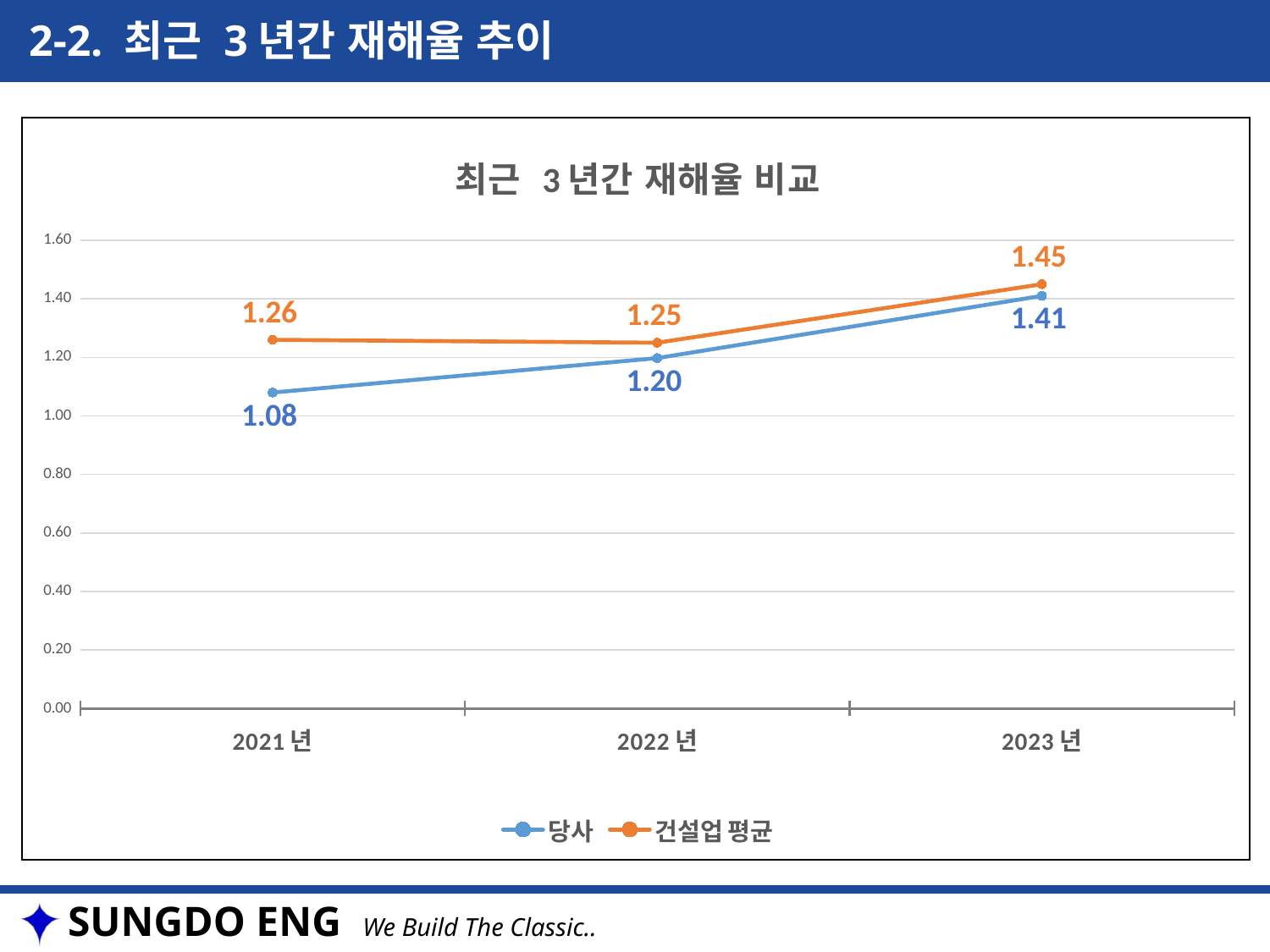
How many years are shown on the x axis? 3 Which is larger in 2023년, 당사 or 건설업 평균? 건설업 평균 What is the value for 당사 in 2022년? 1.20 Is the value for 당사 in 2021년 greater or less than 1.00? greater What kind of chart is shown? line chart What is the value for 건설업 평균 in 2023년? 1.45 In which year is the 건설업 평균 value lowest? 2022년 How many series does the legend list? 2 What is the value for 당사 in 2021년? 1.08 What is the difference between 건설업 평균 and 당사 in 2021년? 0.18 Does the 당사 series rise or fall from 2021년 to 2023년? rise In which year is the 당사 value highest? 2023년